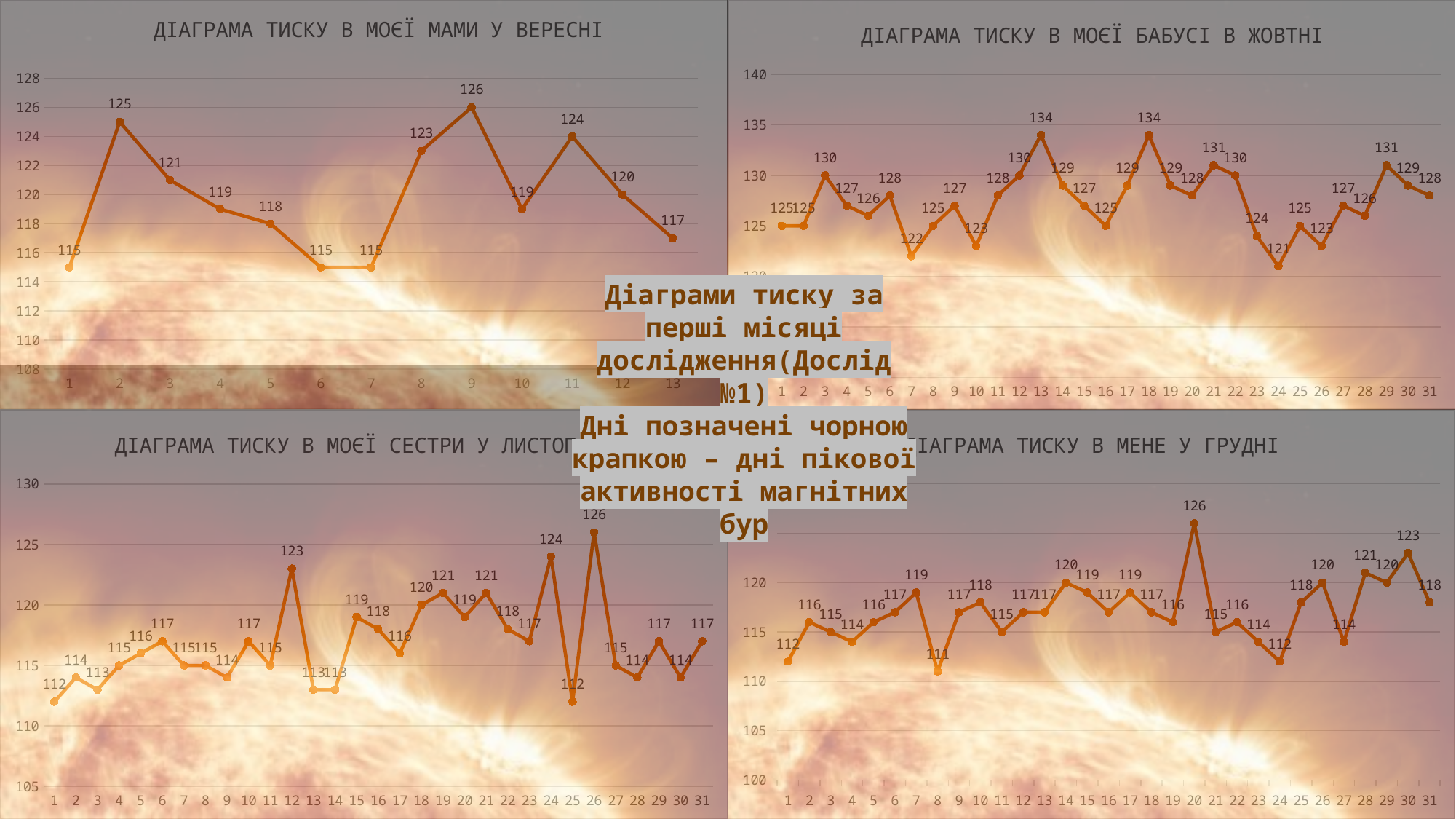
On the bottom-left chart (pressure of my sister), is the value on day 25 greater or less than 115? less On the bottom-left chart (pressure of my sister), on which day is the value highest? 26 On the bottom-left chart (pressure of my sister), what is the value on day 12? 123 On the top-right chart (ДІАГРАМА ТИСКУ В МОЄЇ БАБУСІ В ЖОВТНІ), what is the value on day 24? 121 On the top-left chart (ДІАГРАМА ТИСКУ В МОЄЇ МАМИ У ВЕРЕСНІ), how many data points are plotted? 13 On the bottom-right chart (ДІАГРАМА ТИСКУ В МЕНЕ У ГРУДНІ), on which day is the value lowest? 8 On the bottom-right chart (ДІАГРАМА ТИСКУ В МЕНЕ У ГРУДНІ), what is the value on day 20? 126 On the top-left chart (ДІАГРАМА ТИСКУ В МОЄЇ МАМИ У ВЕРЕСНІ), what is the value on day 9? 126 On the top-left chart (ДІАГРАМА ТИСКУ В МОЄЇ МАМИ У ВЕРЕСНІ), what is the difference between the values on day 2 and day 1? 10 What type of chart is used on this slide? Line chart On the top-right chart (ДІАГРАМА ТИСКУ В МОЄЇ БАБУСІ В ЖОВТНІ), which is larger, the value on day 13 or the value on day 7? day 13 On the top-right chart (ДІАГРАМА ТИСКУ В МОЄЇ БАБУСІ В ЖОВТНІ), what is the highest value shown? 134